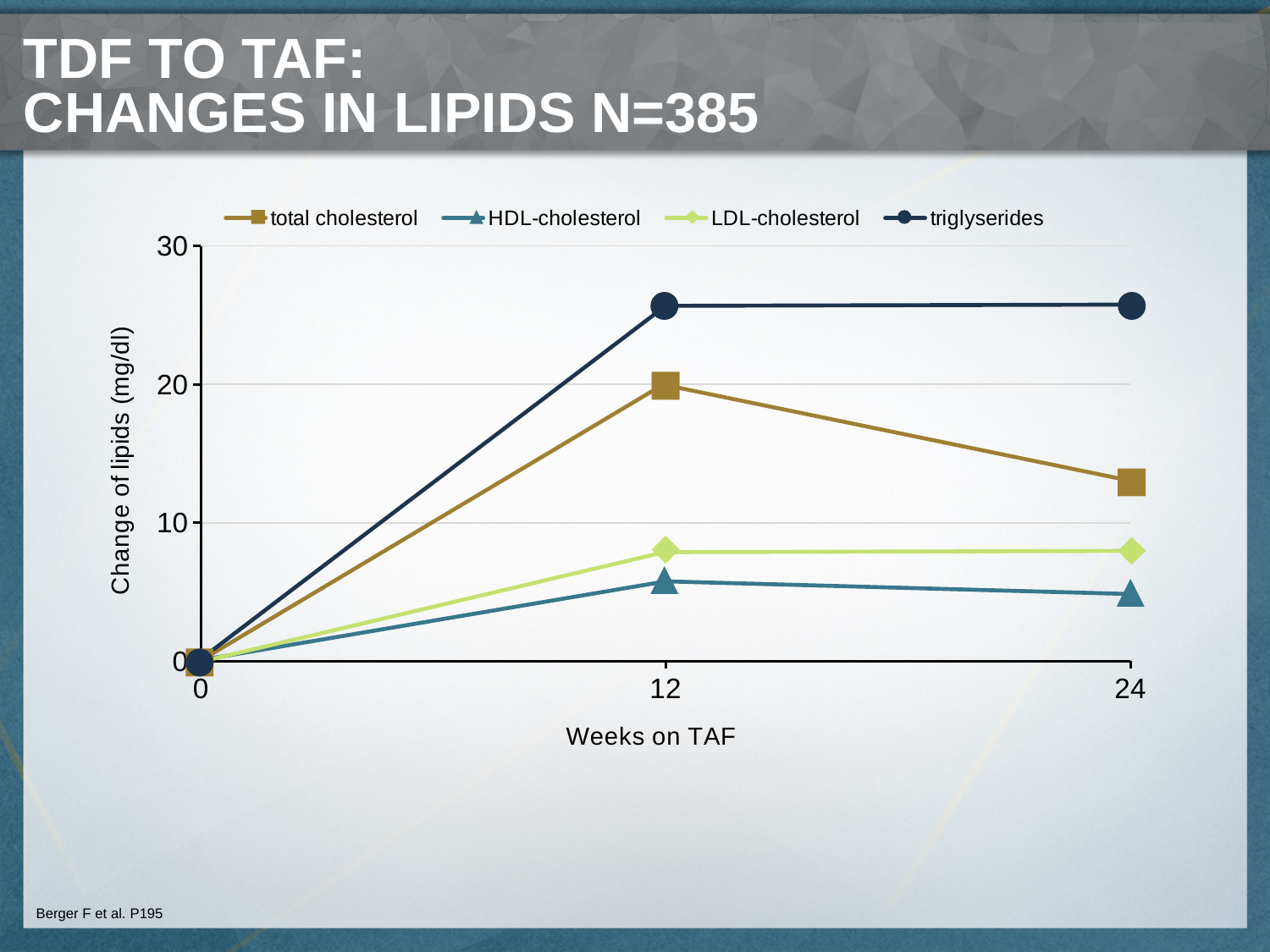
Is the value for triglycerides at week 12 greater or less than 20? greater What is the change in total cholesterol at week 12? 20 How many time points are plotted along the x axis? 3 What kind of chart is shown on the slide? line chart Is the value for total cholesterol at week 24 greater or less than 10? greater Which series has the lowest value at week 24? HDL-cholesterol How many series does the legend list? 4 Which series has the highest value at week 24? triglyserides What is the change in triglycerides at week 0? 0 At week 12, which is larger: total cholesterol or LDL-cholesterol? total cholesterol Is the value for LDL-cholesterol at week 24 greater or less than 10? less Does the total cholesterol line rise or fall between week 12 and week 24? fall